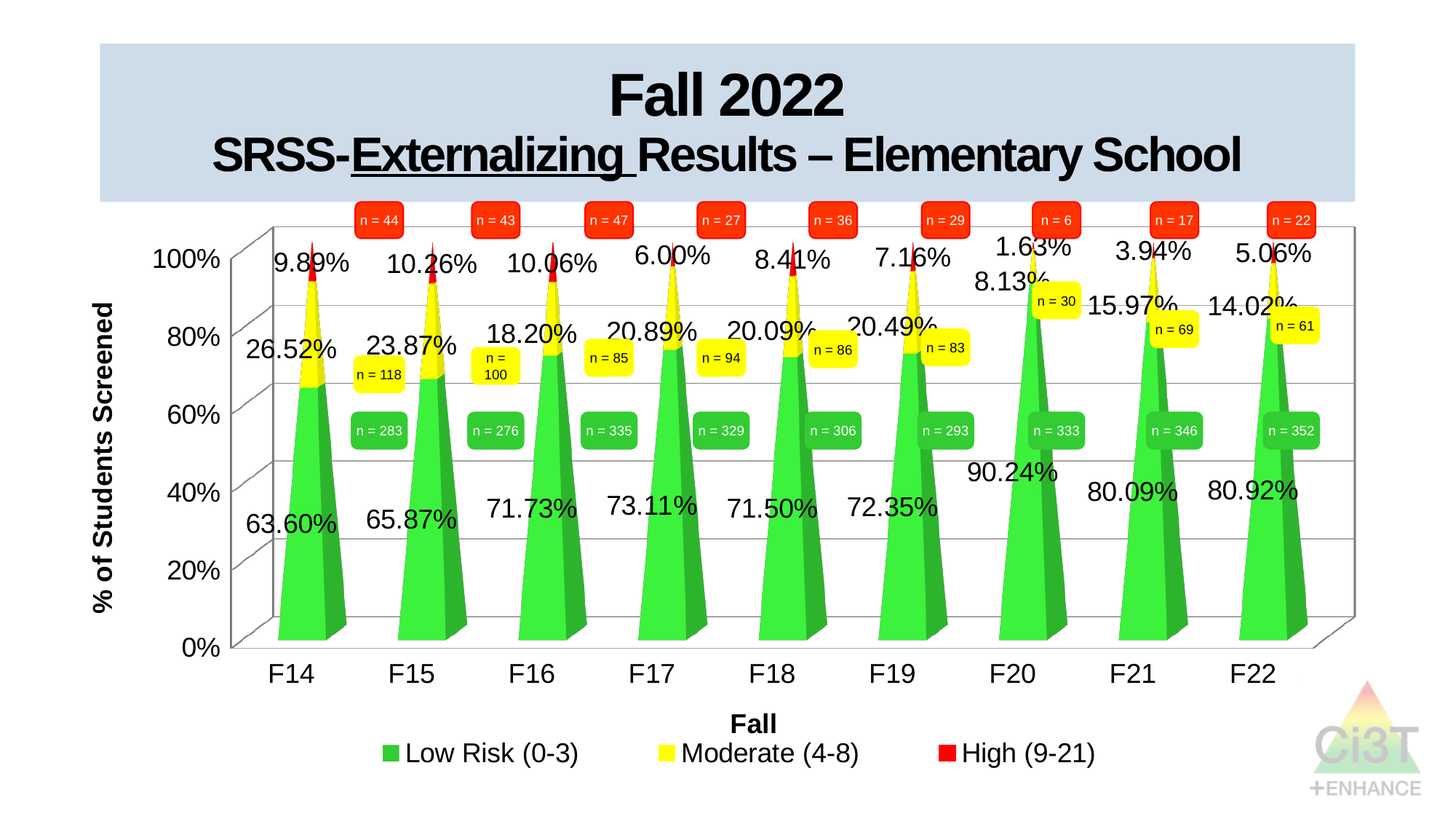
What percentage of students were Moderate (4-8) in F22? 14.02% What is the title of the slide? Fall 2022 SRSS-Externalizing Results – Elementary School What is the difference between the Low Risk (0-3) percentage in F22 and in F21? 0.83 percentage points How many students were in the Low Risk (0-3) group in F21 (the n value)? n = 346 How many series does the legend list? 3 Which fall had the highest Low Risk (0-3) percentage? F20 How many fall screening periods are shown on the x axis? 9 What percentage of students were Low Risk (0-3) in F14? 63.60% What kind of chart is shown on the slide? Stacked bar chart Which is larger, the Moderate (4-8) percentage in F14 or in F15? F14 Which fall had the lowest High (9-21) percentage? F20 What percentage of students were in the High (9-21) category in F17? 6.00%